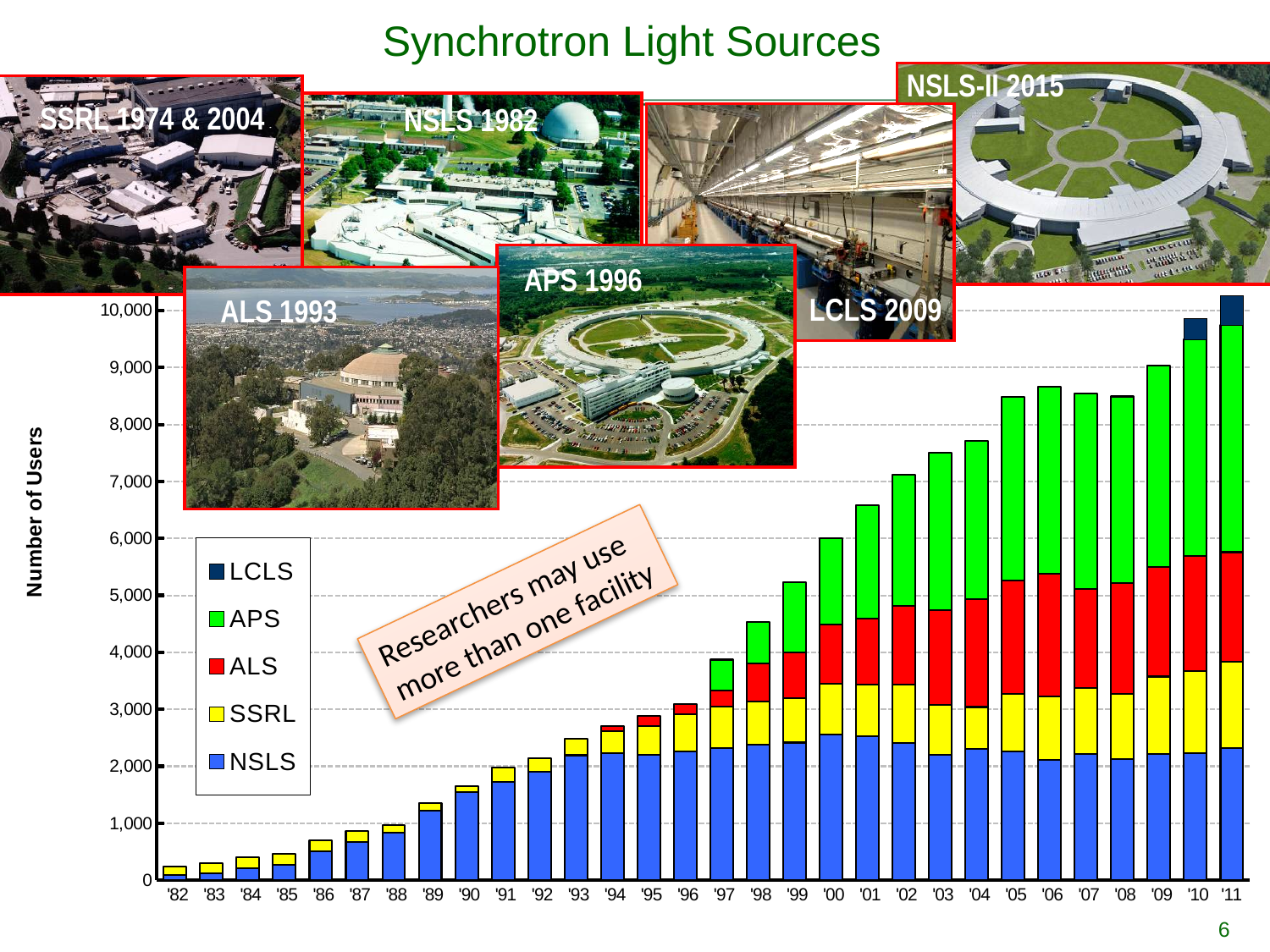
What is the label of the y axis? Number of Users What kind of chart is shown on the slide? stacked bar chart How many years are shown along the x axis of the chart? 30 Which year has the lowest total number of users? '82 Which series is shown at the bottom of each stacked bar? NSLS Which year has a larger total number of users, '00 or '05? '05 Do the total number of users generally rise or fall from '82 to '11? rise How many series does the legend list? 5 Is the total number of users in '86 greater or less than 1,000? less Is the total number of users in '05 greater or less than 8,000? greater Is the total number of users in '10 greater or less than 9,000? greater Which year has the highest total number of users? '11